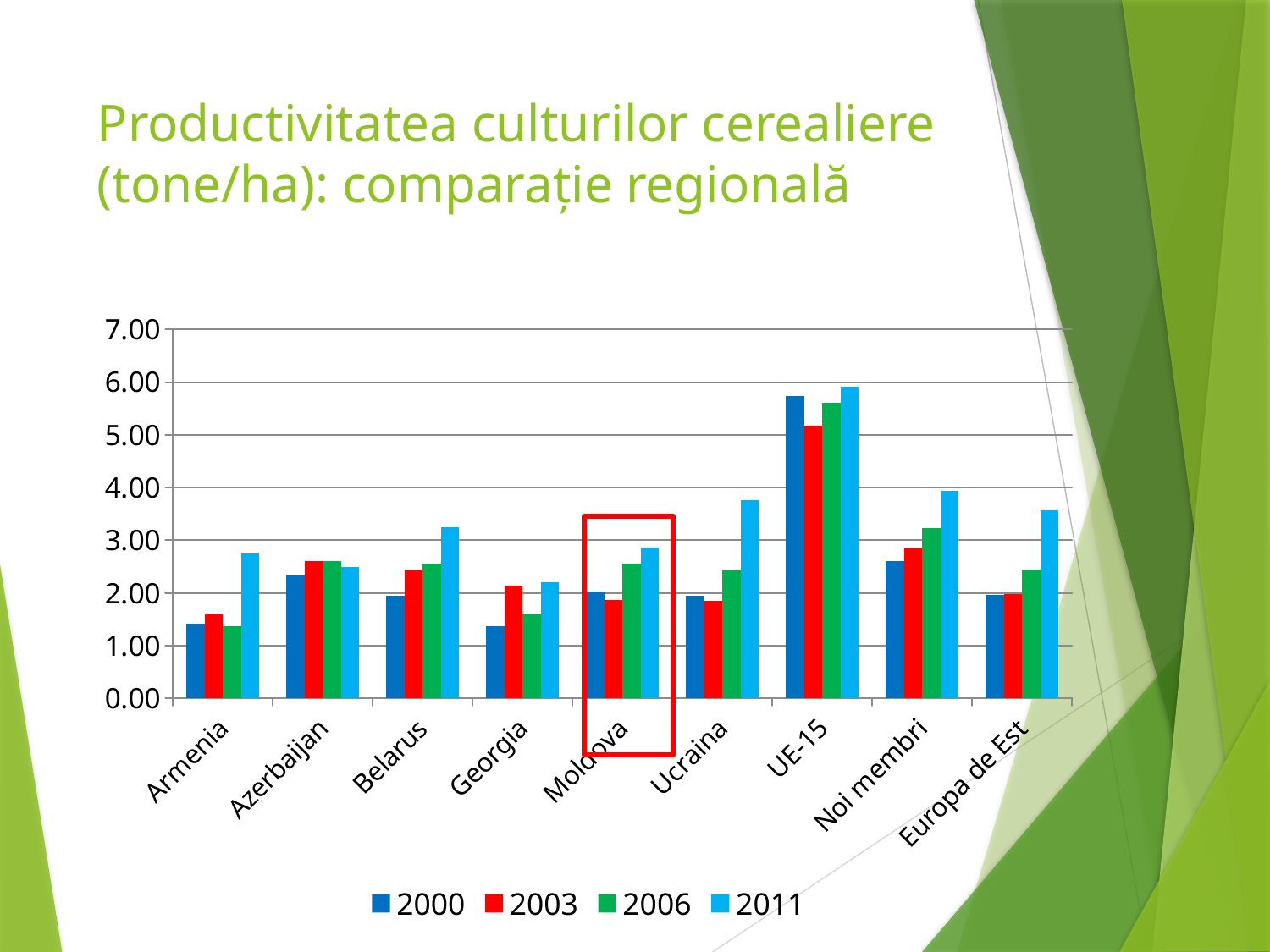
Which is larger for UE-15: the value for 2000 or the value for 2003? 2000 Which category has the lowest value for 2011? Georgia Which category on the chart is highlighted with a red box? Moldova Do the values for Belarus rise or fall from 2000 to 2011? rise Which is larger for Georgia: the value for 2003 or the value for 2006? 2003 Which category has the highest value for 2011? UE-15 How many countries or regions are shown on the x axis of the chart? 9 What kind of chart is shown on the slide? bar chart Is the value for Armenia in 2000 greater or less than 2.00? less Is the value for Ucraina in 2011 greater or less than 3.00? greater Is the value for UE-15 in 2011 greater or less than 5.00? greater How many series does the legend of the chart list? 4